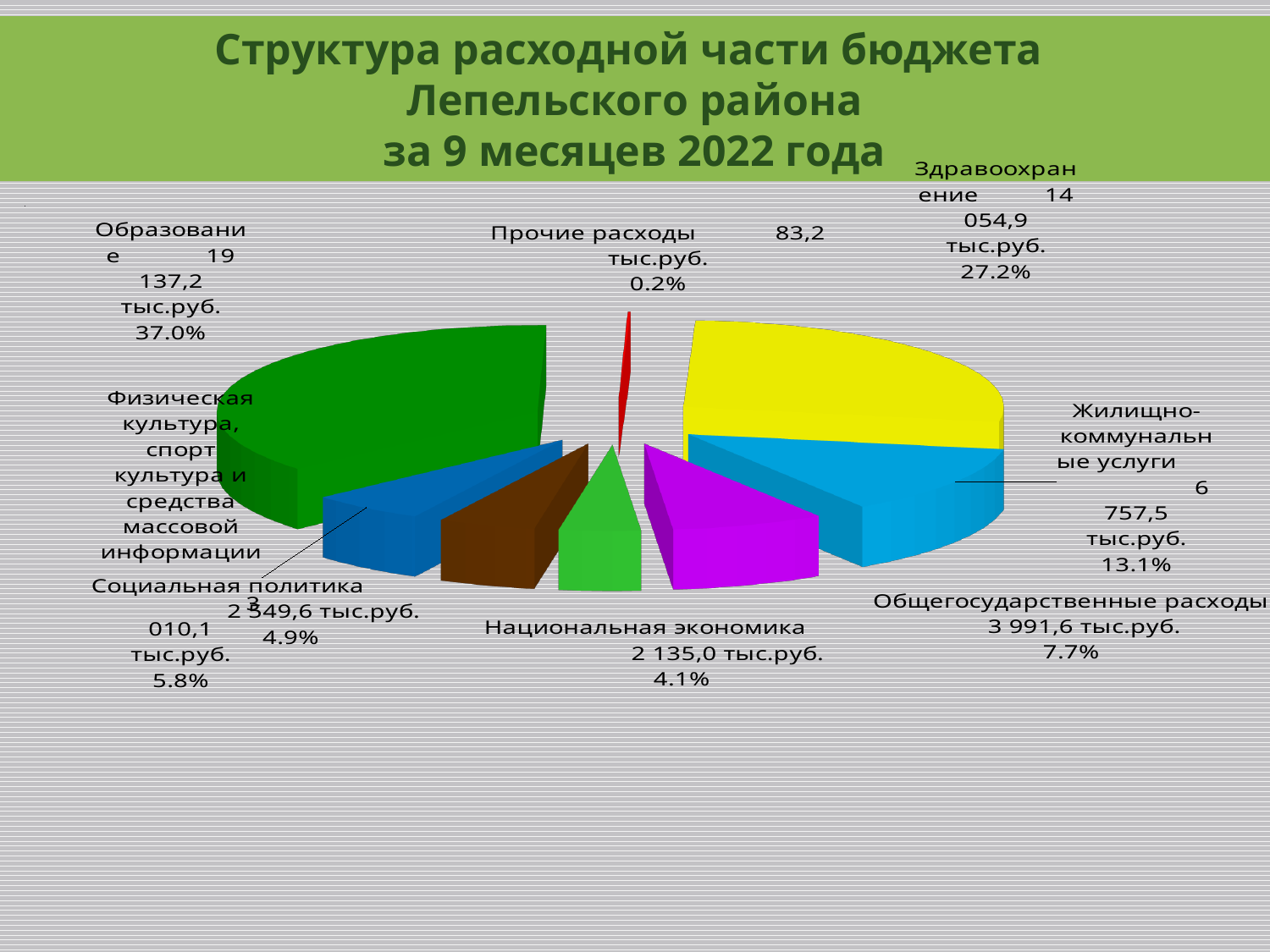
Which category has the smallest share of the budget expenditure? Прочие расходы Which is larger: Социальная политика or Национальная экономика? Социальная политика What is the value for Образование in тыс.руб.? 19 137,2 тыс.руб. How many categories (slices) does the pie chart show? 8 What is the difference in percentage points between Образование (37.0%) and Здравоохранение (27.2%)? 9.8 percentage points What type of chart is shown on the slide? Pie chart What percentage share does Общегосударственные расходы have? 7.7% What is the title of the chart? Структура расходной части бюджета Лепельского района за 9 месяцев 2022 года What is the value for Жилищно-коммунальные услуги in тыс.руб.? 6 757,5 тыс.руб. Which category has the largest share of the budget expenditure? Образование What percentage share does Здравоохранение have? 27.2% What is the value for Национальная экономика in тыс.руб.? 2 135,0 тыс.руб.